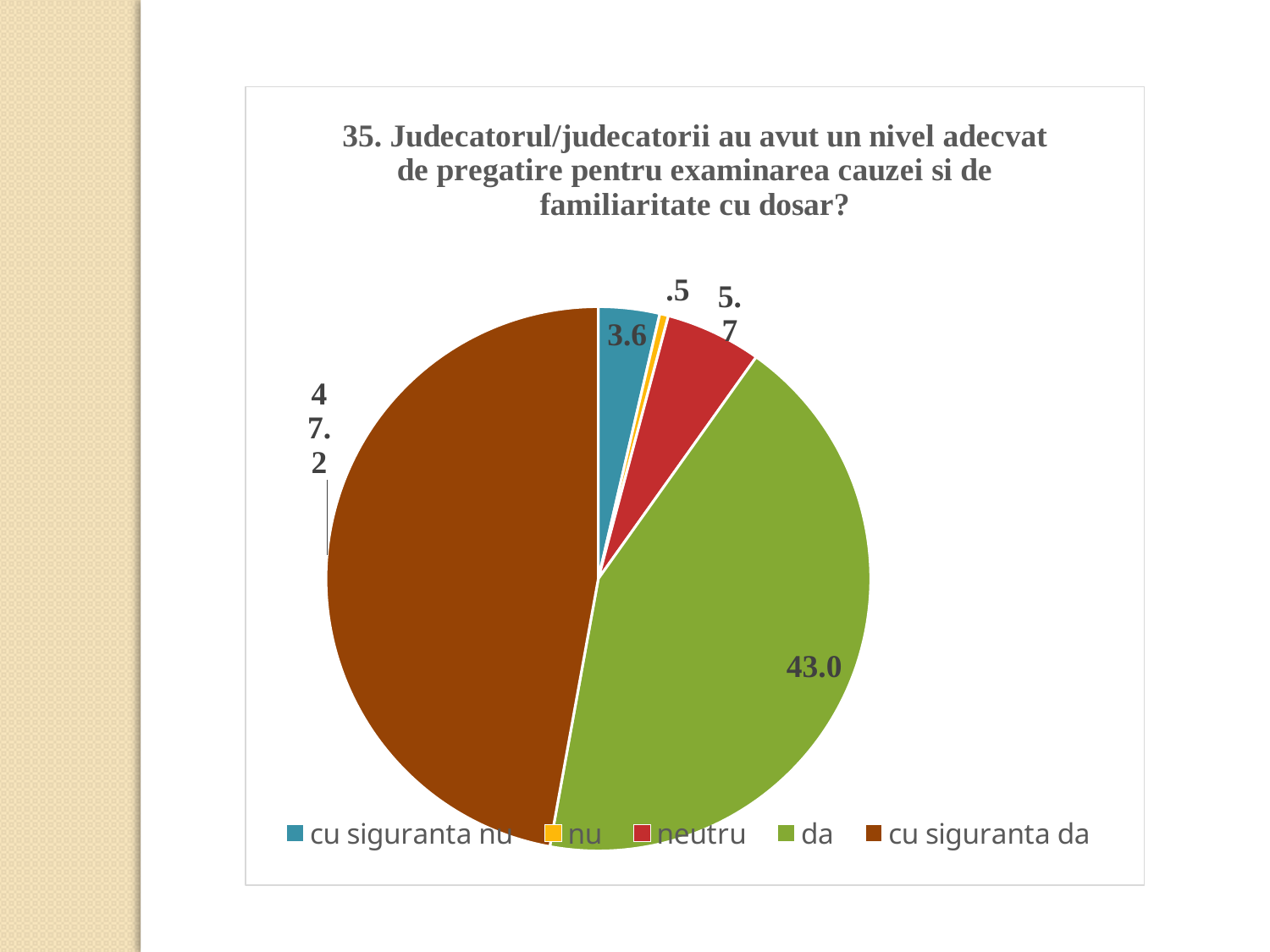
What is the value for "da"? 43.0 Which category has the smallest slice of the pie? nu Which colour represents "da" in the pie chart? green Which is larger, the value for "neutru" or the value for "cu siguranta nu"? neutru What is the value for "nu"? .5 What is the value for "cu siguranta da"? 47.2 What kind of chart is shown on the slide? pie chart What is the value for "neutru"? 5.7 What is the difference between the values for "cu siguranta da" and "da"? 4.2 Which category has the largest slice of the pie? cu siguranta da How many categories does the legend list? 5 What is the value for "cu siguranta nu"? 3.6